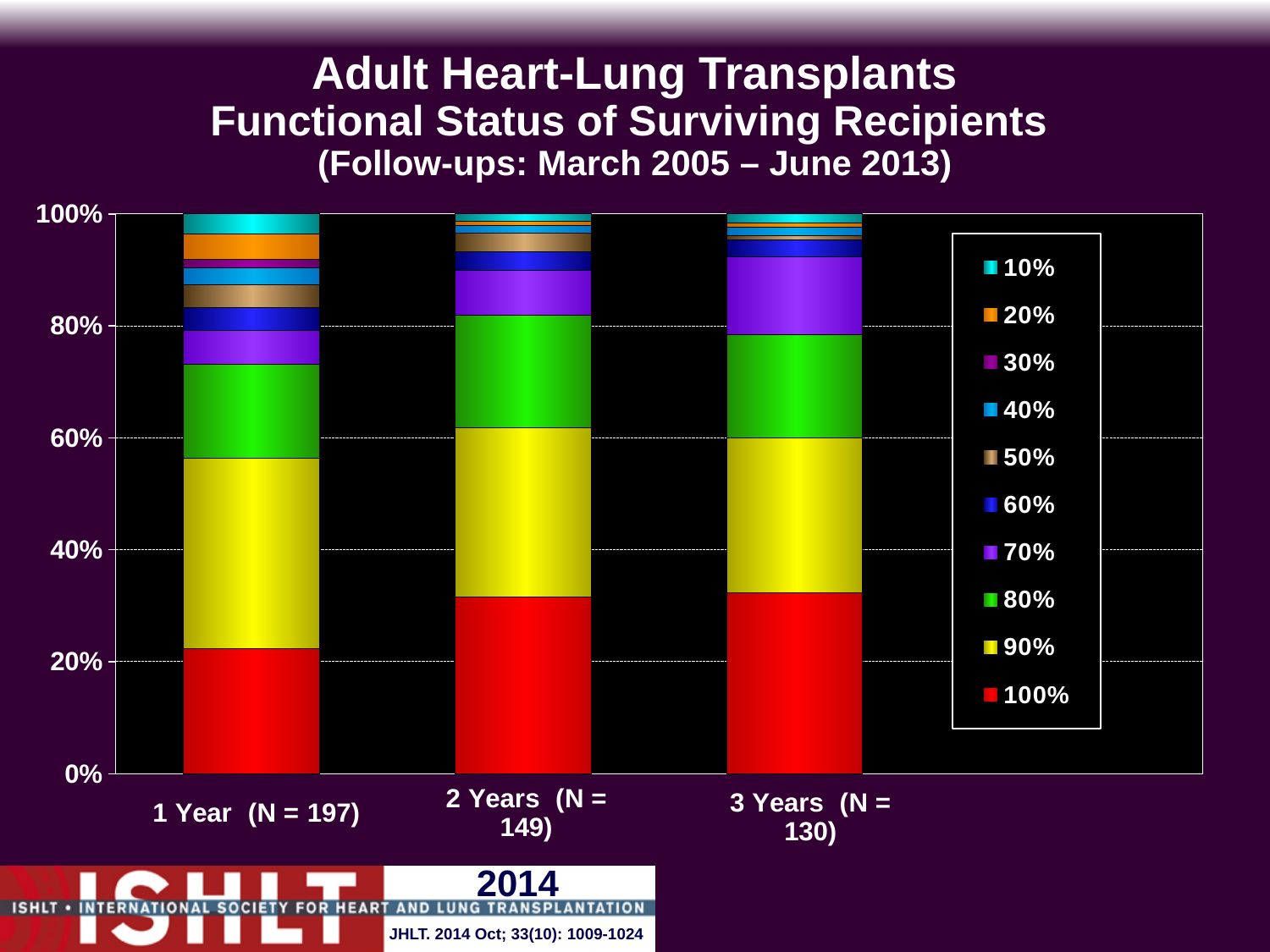
What colour represents the 100% functional status series in the legend? Red Which bar has the larger 100% functional status (red) segment, 1 Year or 3 Years? 3 Years What is the N (number of recipients) for the 2 Years bar? 149 Is the 100% functional status segment for 3 Years greater or less than 20%? greater Which follow-up time point has the largest 20% functional status (orange) segment? 1 Year What kind of chart is shown on the slide? Stacked bar chart What is the total height of the 1 Year stacked bar? 100% How many bars (follow-up time points) are plotted in the chart? 3 Does the 100% functional status segment rise or fall from 1 Year to 3 Years? rise How many series does the legend list? 10 Is the 100% functional status segment for 2 Years greater or less than 40%? less Is the 100% functional status segment for 1 Year greater or less than 20%? greater